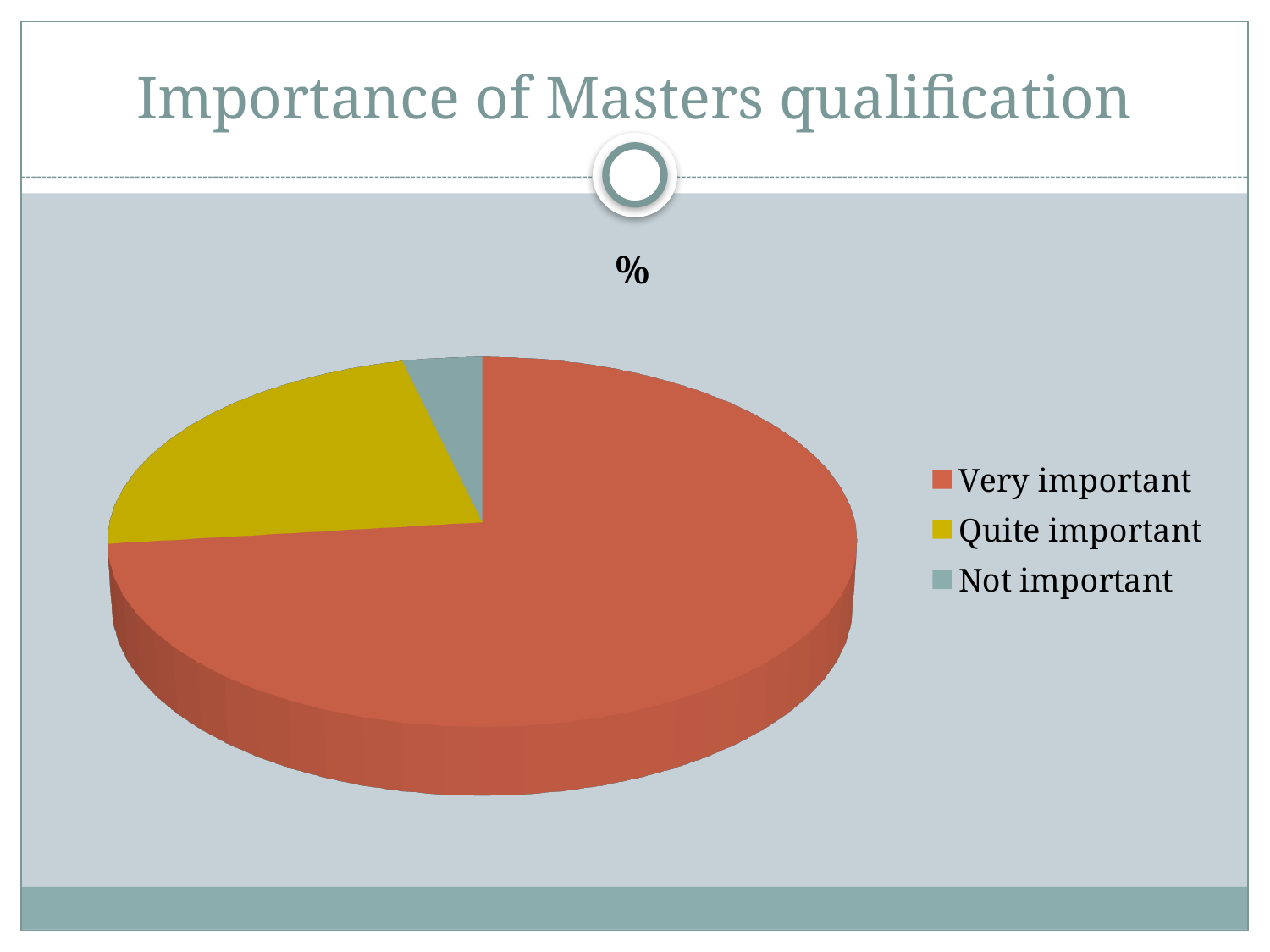
Which category has the smallest slice of the pie? Not important What is the title shown above the pie chart? % How many entries does the legend list? 3 What colour is the Quite important slice? yellow Which slice is smaller, Very important or Not important? Not important Which category has the largest slice of the pie? Very important Which slice is larger, Quite important or Not important? Quite important How many slices does the pie chart have? 3 What kind of chart is shown on the slide? pie chart Which slice is larger, Very important or Quite important? Very important